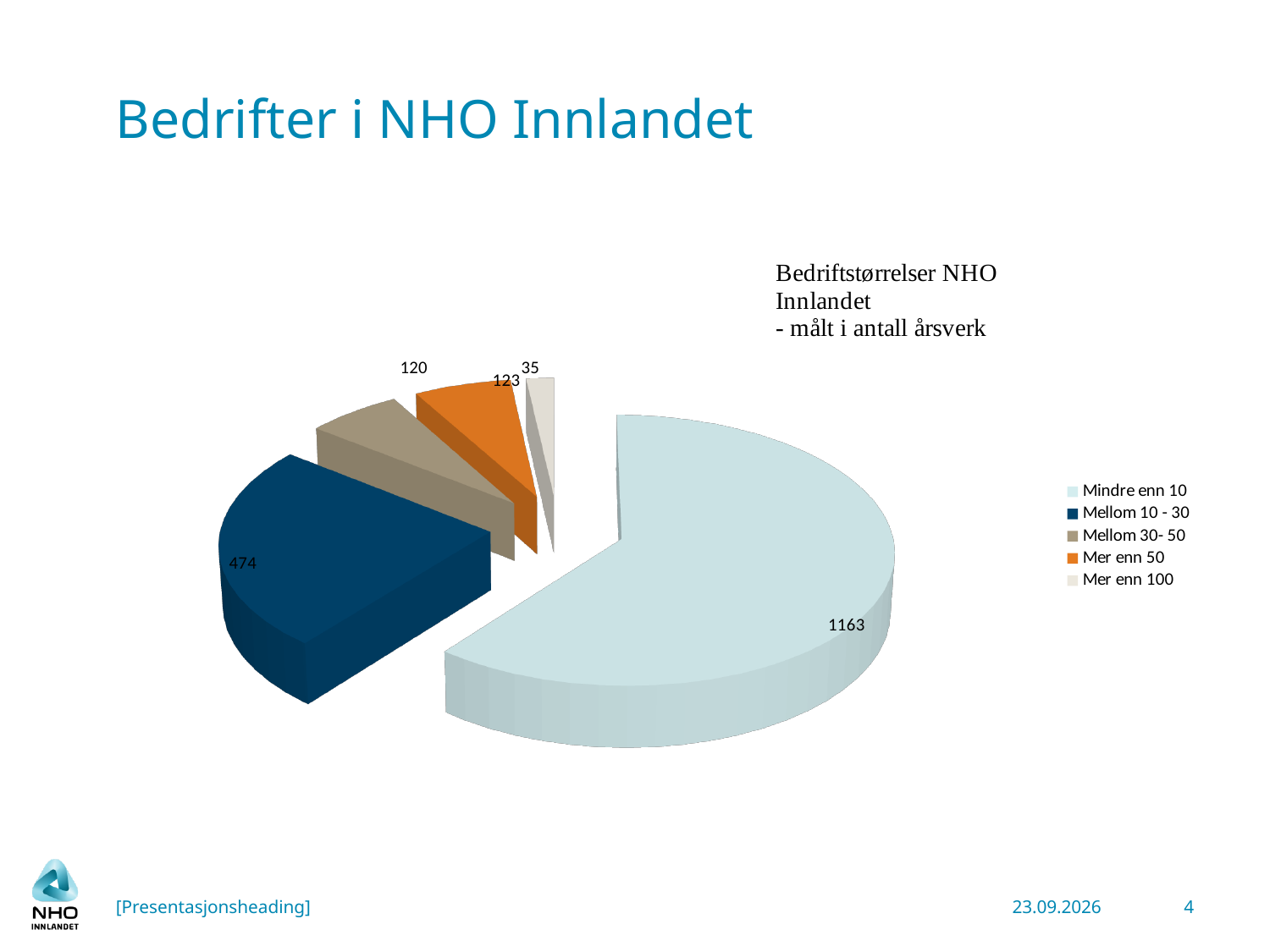
What is the value for 'Mindre enn 10'? 1163 What is the value for 'Mer enn 50'? 123 How many categories does the legend list? 5 What is the title of the chart? Bedriftstørrelser NHO Innlandet - målt i antall årsverk What is the difference between the values for 'Mindre enn 10' and 'Mellom 10 - 30'? 689 What is the value for 'Mellom 10 - 30'? 474 Which is larger, the value for 'Mellom 10 - 30' or the value for 'Mellom 30- 50'? Mellom 10 - 30 Which category has the largest slice? Mindre enn 10 What kind of chart is shown on the slide? pie chart What is the value for 'Mer enn 100'? 35 Which category has the smallest slice? Mer enn 100 What colour is the slice for 'Mer enn 50'? orange